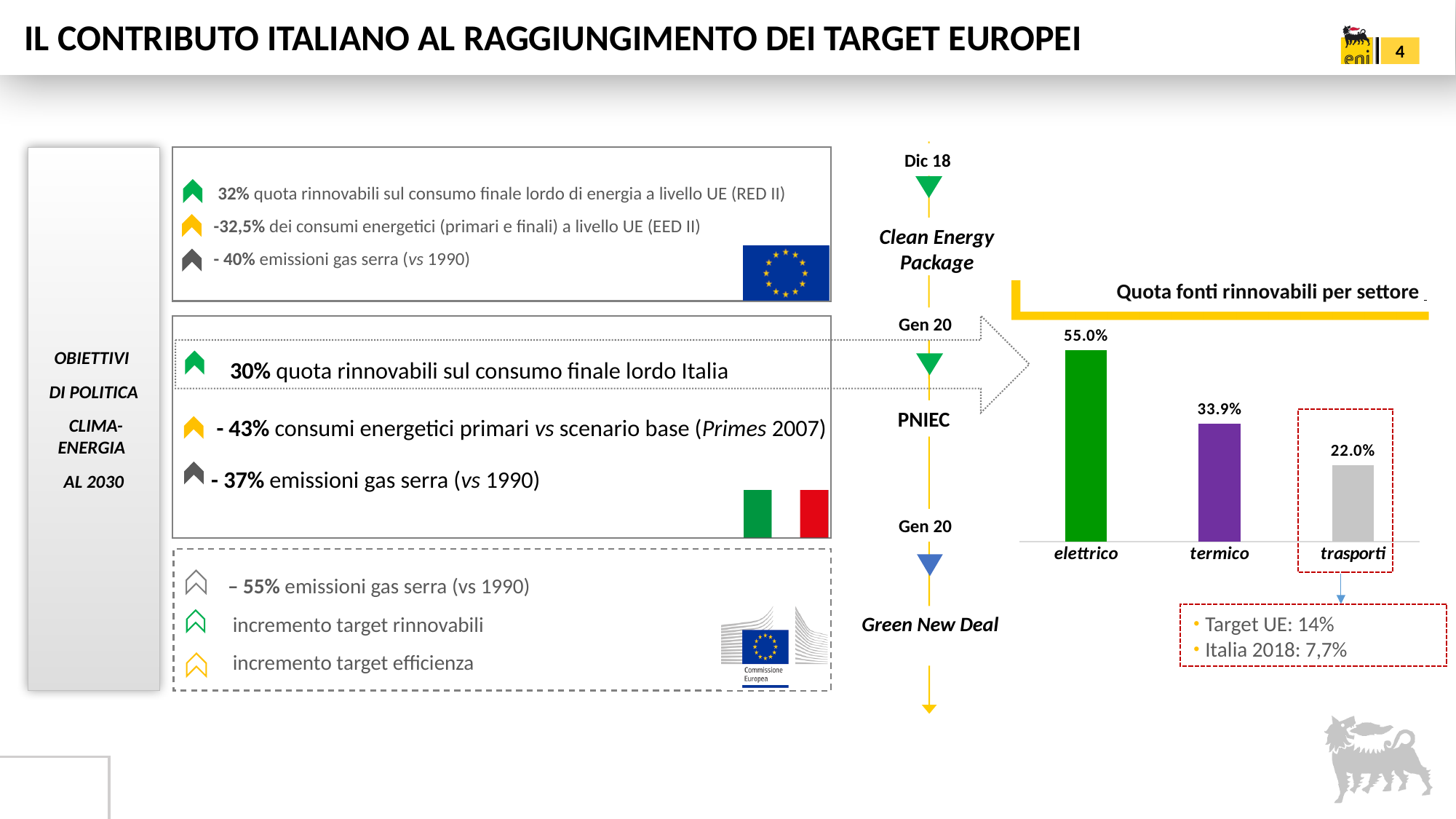
What is the value for termico in the 'Quota fonti rinnovabili per settore' chart? 33.9% Which sector has the highest renewable share in the 'Quota fonti rinnovabili per settore' chart? elettrico What kind of chart is 'Quota fonti rinnovabili per settore'? bar chart What is the value for elettrico in the 'Quota fonti rinnovabili per settore' chart? 55.0% Which sector has the lowest renewable share in the 'Quota fonti rinnovabili per settore' chart? trasporti What is the title of the chart on the right side of the slide? Quota fonti rinnovabili per settore What is the difference between the elettrico and termico values in the 'Quota fonti rinnovabili per settore' chart? 21.1% How many sectors are shown in the 'Quota fonti rinnovabili per settore' chart? 3 What colour is the elettrico bar in the 'Quota fonti rinnovabili per settore' chart? green What is the value for trasporti in the 'Quota fonti rinnovabili per settore' chart? 22.0% What is the difference between the termico and trasporti values in the 'Quota fonti rinnovabili per settore' chart? 11.9% In the 'Quota fonti rinnovabili per settore' chart, which is larger: termico or trasporti? termico